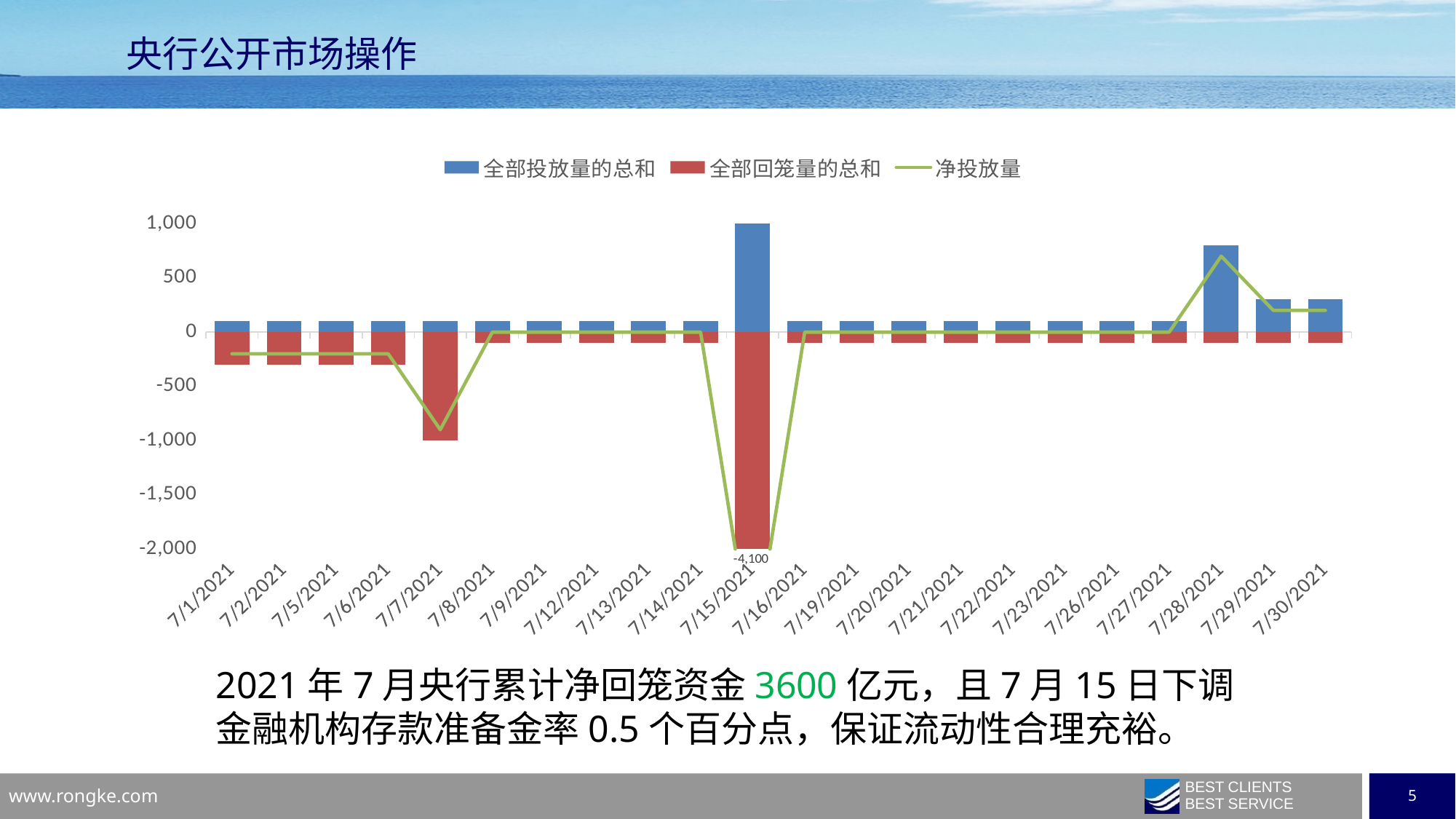
What is the value of 全部回笼量的总和 on 7/15/2021? -4,100 Is the value of 全部回笼量的总和 on 7/7/2021 greater or less than -500? less Which date has the larger 全部投放量的总和, 7/28/2021 or 7/29/2021? 7/28/2021 On which date is 净投放量 the lowest? 7/15/2021 What colour are the bars for 全部回笼量的总和? Red On which date is 全部投放量的总和 the highest? 7/15/2021 Is the value of 全部投放量的总和 on 7/28/2021 greater or less than 500? greater Does 净投放量 rise or fall from 7/27/2021 to 7/28/2021? rise What kind of chart is shown on the slide? A combination bar and line chart Is the value of 净投放量 on 7/28/2021 greater or less than 500? greater How many dates are shown on the x axis? 22 How many series does the legend list? 3